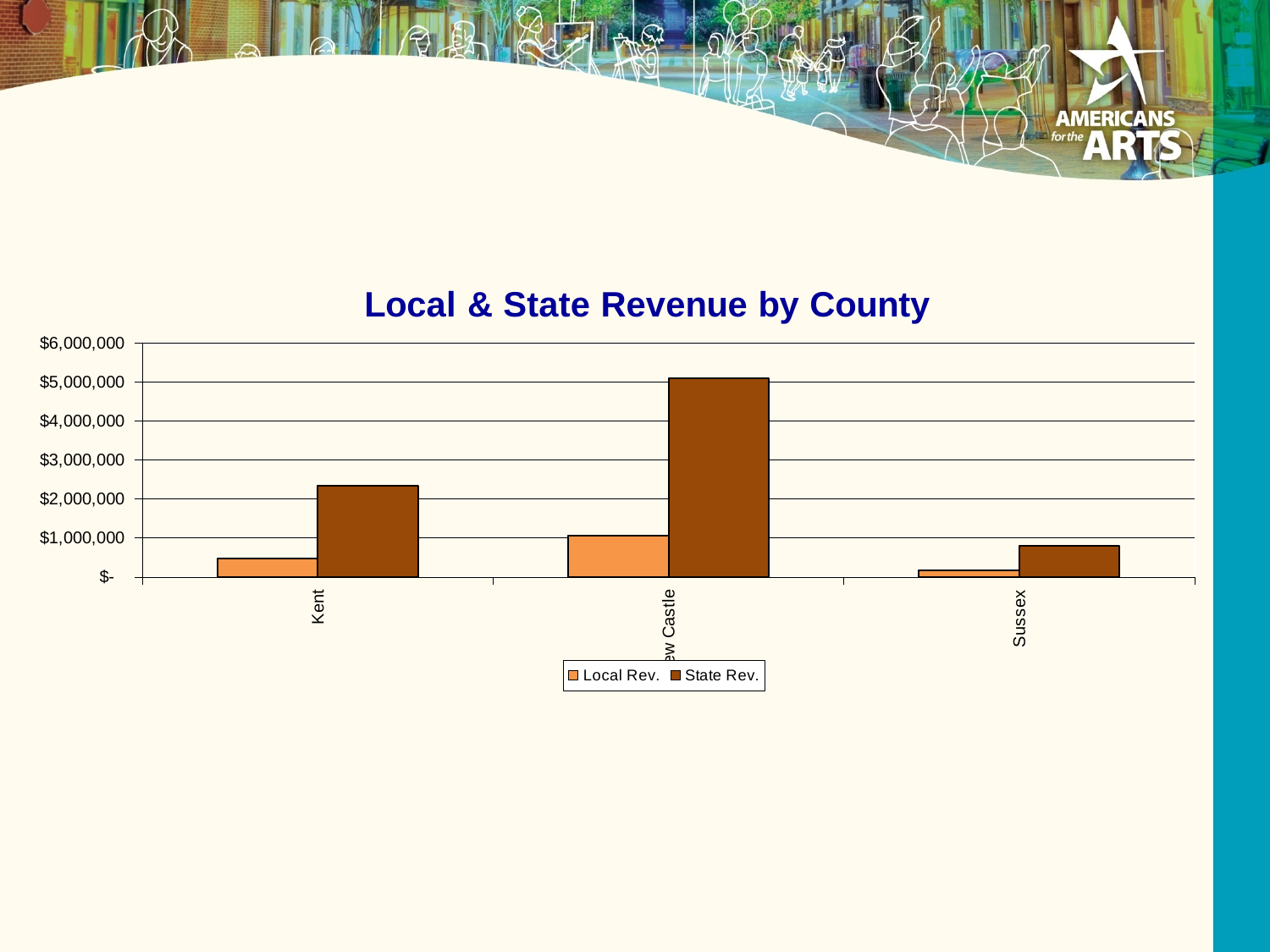
Is the State Rev. value for Kent greater or less than $2,000,000? greater Is the State Rev. value for New Castle greater or less than $4,000,000? greater Is the State Rev. value for Sussex greater or less than $1,000,000? less What type of chart is shown on the slide? Bar chart What is the title of the chart? Local & State Revenue by County How many series does the legend list? 2 How many counties are shown on the x axis? 3 Which county has the highest State Rev. bar? New Castle Which series is shown in the darker brown colour in the legend? State Rev. Which is larger, the State Rev. for Kent or the State Rev. for Sussex? Kent Which county has the lowest Local Rev. bar? Sussex